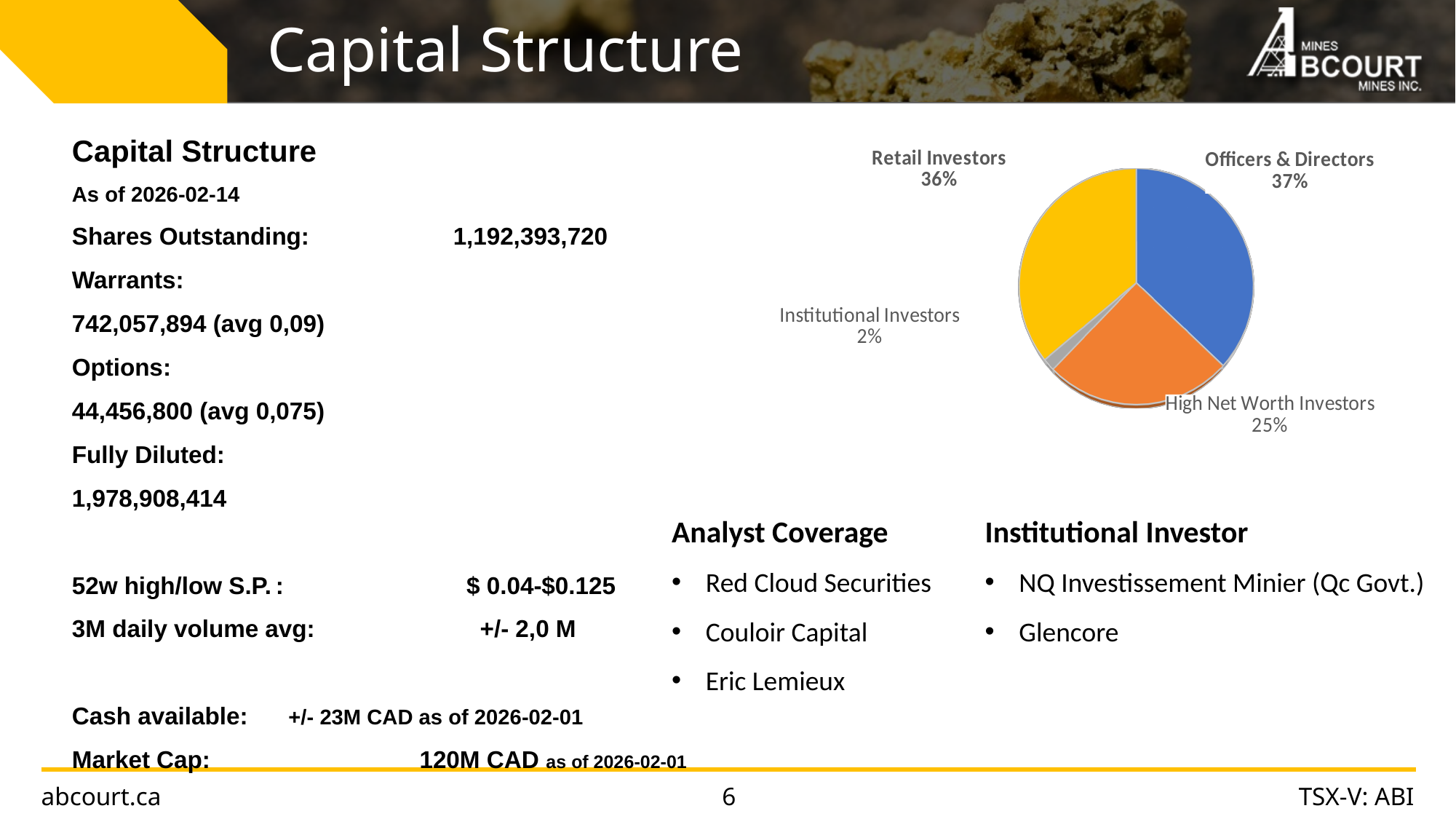
What colour is the Retail Investors slice in the pie chart? yellow What is the difference in percentage points between Officers & Directors and High Net Worth Investors in the pie chart? 12 What is the value shown for Officers & Directors in the pie chart? 37% Which is larger in the pie chart: Retail Investors or High Net Worth Investors? Retail Investors What is the value shown for High Net Worth Investors in the pie chart? 25% What is the difference in percentage points between Retail Investors and Institutional Investors in the pie chart? 34 Which category has the largest slice in the pie chart? Officers & Directors What type of chart is shown on the slide? pie chart How many slices does the pie chart have? 4 What is the value shown for Institutional Investors in the pie chart? 2% What share of the pie chart is held by Retail Investors? 36% Which category has the smallest slice in the pie chart? Institutional Investors